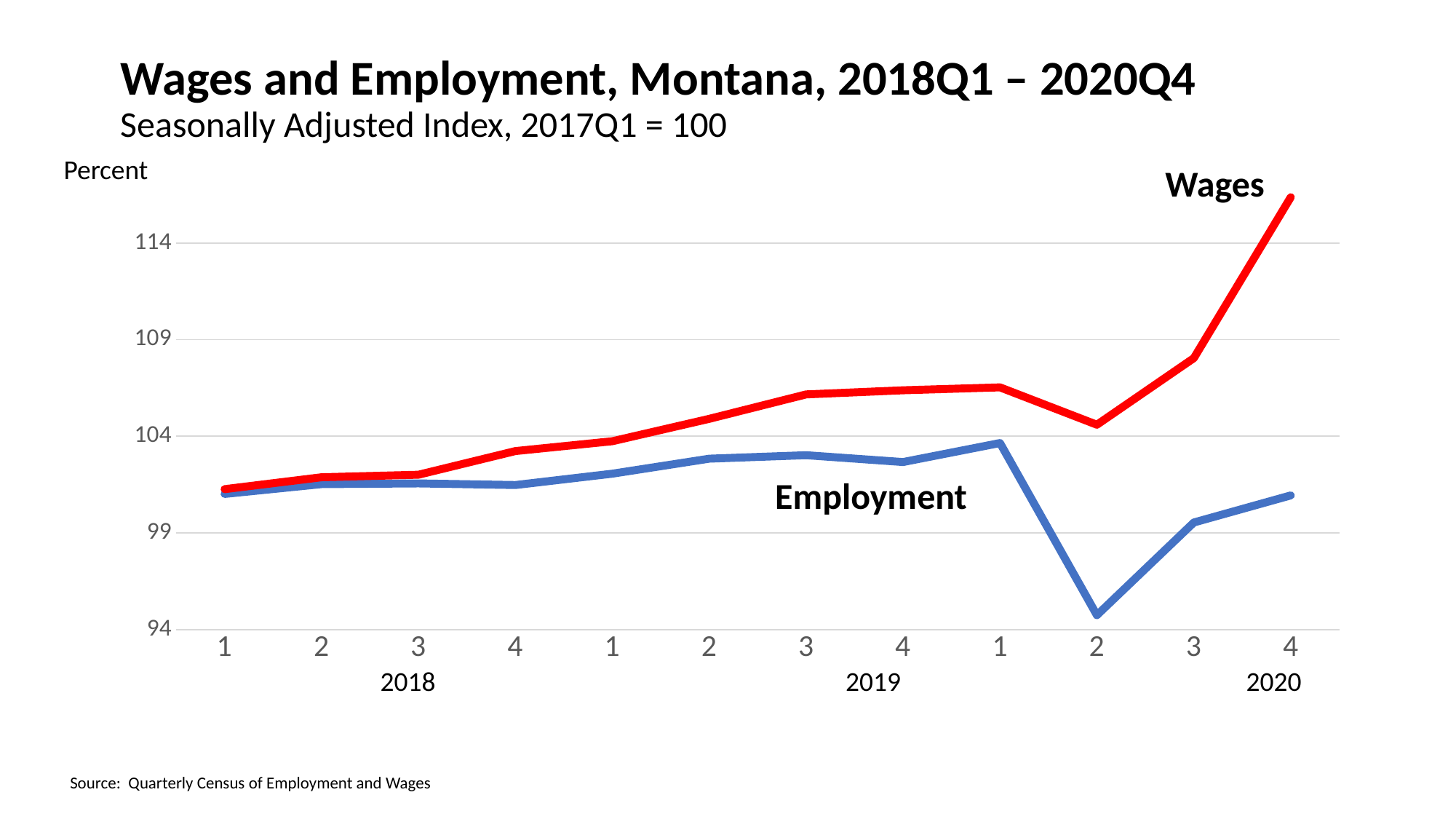
How many quarterly data points does each line have? 12 Does the Employment line rise or fall from 2020 Q2 to 2020 Q4? Rise Is the Wages value for 2020 Q4 greater or less than 114? greater How many series are plotted on the chart? 2 What is the source cited for the chart? Quarterly Census of Employment and Wages Is the Wages value for 2019 Q3 greater or less than 104? greater In which quarter does the Employment line reach its lowest value? 2020 Q2 In which quarter does the Wages line reach its highest value? 2020 Q4 What kind of chart is shown on the slide? Line chart Is the Employment value for 2020 Q2 greater or less than 99? less At 2020 Q4, which is larger, Wages or Employment? Wages